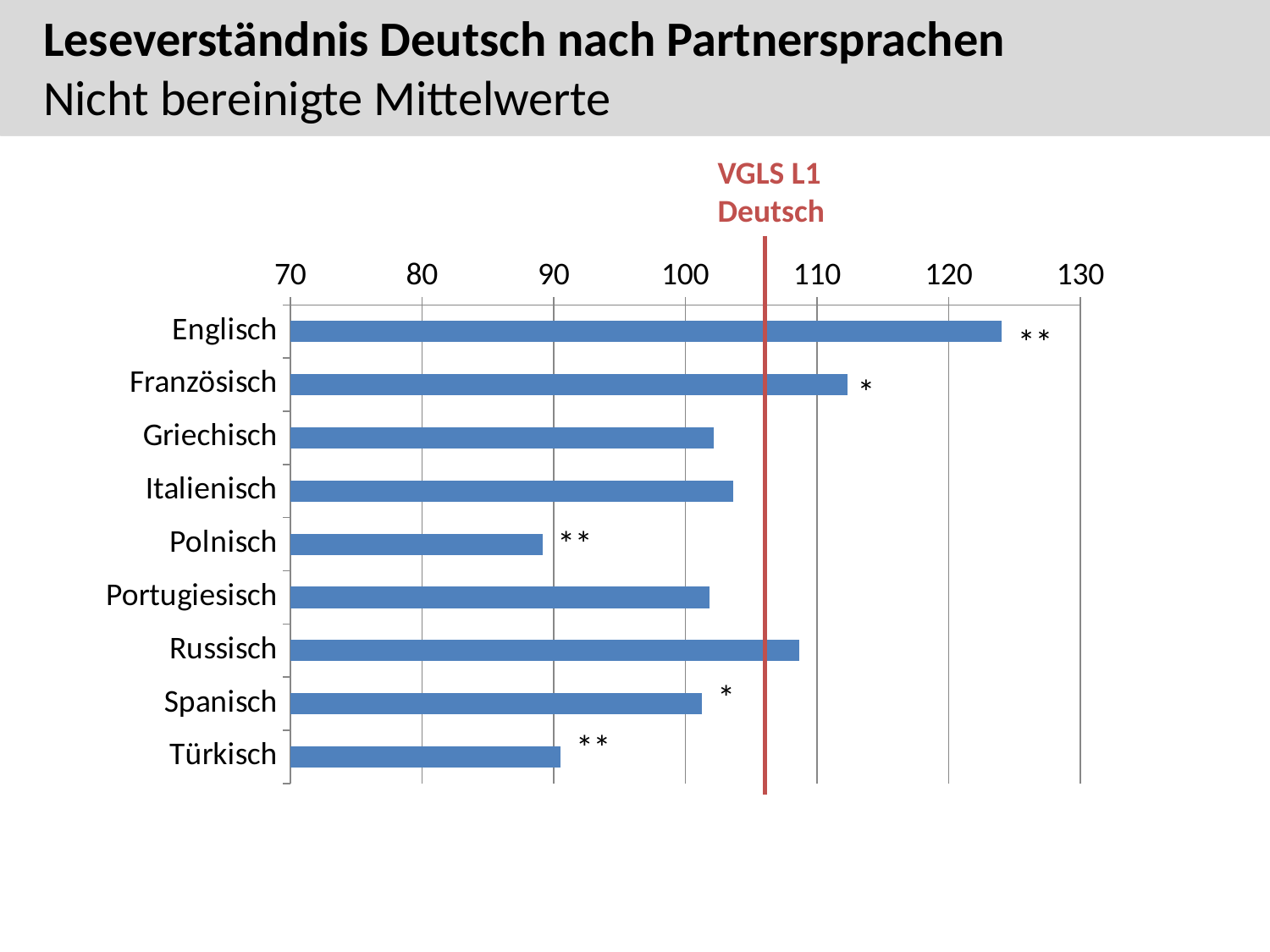
What label is given to the red vertical reference line in the chart? VGLS L1 Deutsch Which has the larger value, Russisch or Italienisch? Russisch Which has the larger value, Englisch or Französisch? Englisch Which partner language has the lowest value in the chart? Polnisch Is the value for Russisch greater or less than 100? greater How many partner languages (categories) are plotted in the chart? 9 What kind of chart is shown on the slide? bar chart Is the value for Türkisch greater or less than 100? less Which partner language has the highest value in the chart? Englisch Is the value for Französisch greater or less than 110? greater